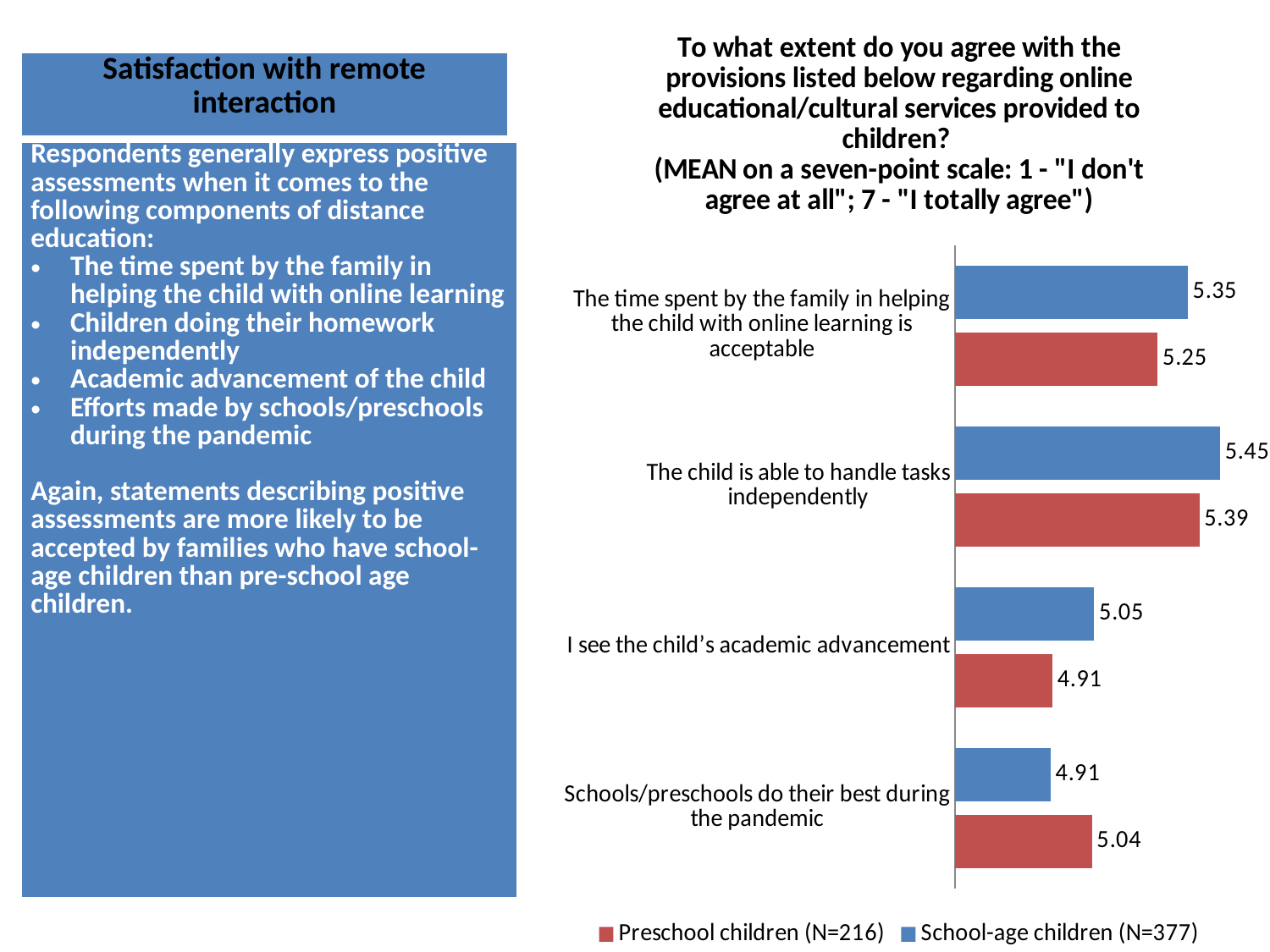
Which statement has the highest value for School-age children (N=377)? The child is able to handle tasks independently Which colour represents Preschool children (N=216) in the chart? Red What is the value for Preschool children (N=216) for "Schools/preschools do their best during the pandemic"? 5.04 How many series does the legend list? 2 For "Schools/preschools do their best during the pandemic", which group has the larger value, Preschool children or School-age children? Preschool children (N=216) What is the difference between the School-age children and Preschool children values for "I see the child's academic advancement"? 0.14 What is the value for Preschool children (N=216) for "I see the child's academic advancement"? 4.91 What kind of chart is shown on the slide? Bar chart What is the value for School-age children (N=377) for "The time spent by the family in helping the child with online learning is acceptable"? 5.35 How many statements (categories) are shown in the chart? 4 What is the value for School-age children (N=377) for "The child is able to handle tasks independently"? 5.45 Which statement has the lowest value for Preschool children (N=216)? I see the child's academic advancement